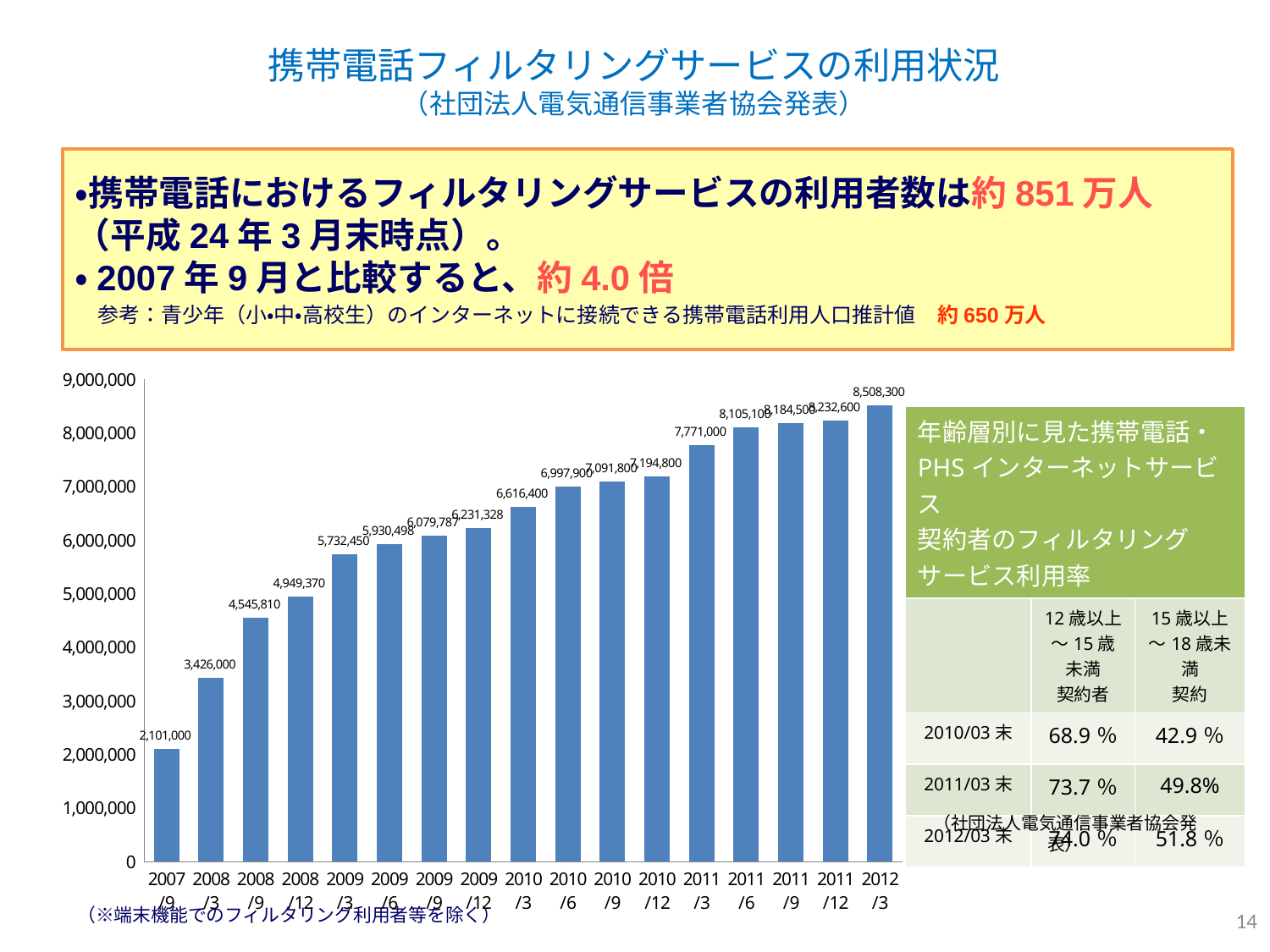
What is the value for 2010/3 in the bar chart? 6,616,400 Do the values in the bar chart rise or fall from 2007/9 to 2012/3? rise What is the value for 2012/3 in the bar chart? 8,508,300 What is the difference between the values for 2008/3 and 2007/9 in the bar chart? 1,325,000 What is the value for 2007/9 in the bar chart? 2,101,000 How many bars are shown in the bar chart? 17 Is the value for 2009/6 in the bar chart greater or less than 5,000,000? greater Which is larger in the bar chart, the value for 2008/3 or the value for 2009/3? 2009/3 Which period has the lowest value in the bar chart? 2007/9 What is the difference between the values for 2012/3 and 2007/9 in the bar chart? 6,407,300 Which period has the highest value in the bar chart? 2012/3 What is the value for 2011/3 in the bar chart? 7,771,000